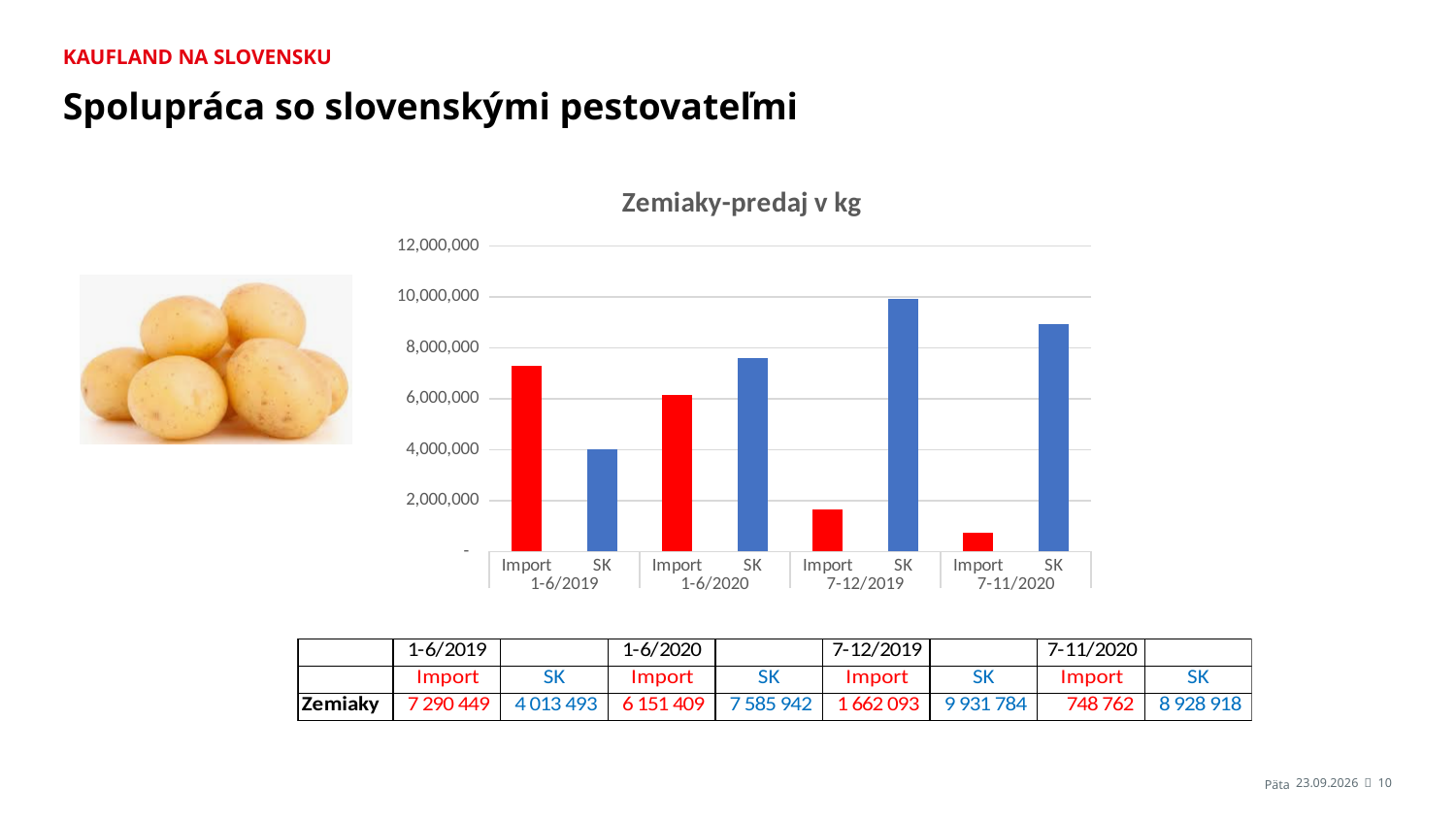
What is the difference between SK and Import in 7-12/2019? 8 269 691 What kind of chart is shown on the slide? bar chart Which is larger in 1-6/2020, Import or SK? SK How many bars are plotted in the chart? 8 What is the title of the chart? Zemiaky-predaj v kg Which bar has the highest value? SK 7-12/2019 What colour are the Import bars? red Which bar has the lowest value? Import 7-11/2020 Is the value for SK 7-12/2019 greater or less than 8,000,000? greater What is the value for SK in 7-11/2020? 8 928 918 Do the Import values rise or fall across the periods from left to right? fall What is the value for Import in 1-6/2019? 7 290 449